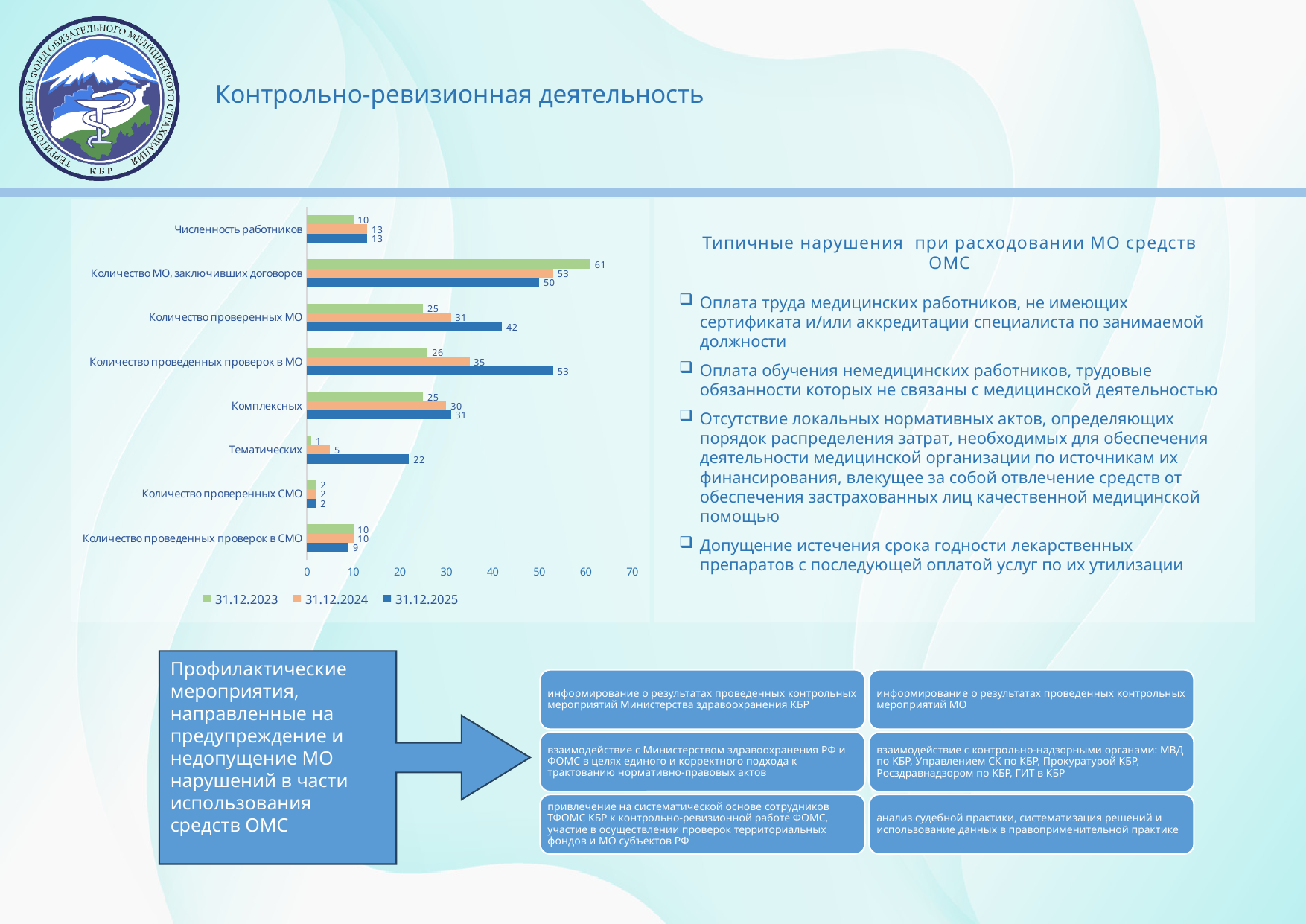
What is the value for "Тематических" in the 31.12.2023 series? 1 How many series does the chart legend list? 3 What is the value for "Количество МО, заключивших договоров" in the 31.12.2024 series? 53 Which category has the highest value in the 31.12.2023 series? Количество МО, заключивших договоров What is the difference between the 31.12.2025 and 31.12.2023 values for "Количество проведенных проверок в МО"? 27 How many categories are shown on the chart? 8 What is the value for "Количество проверенных МО" in the 31.12.2025 series? 42 Is the 31.12.2025 value for "Количество проведенных проверок в МО" greater or less than 50? greater For "Тематических", which series has the larger value: 31.12.2024 or 31.12.2025? 31.12.2025 What are the three series listed in the chart legend? 31.12.2023, 31.12.2024, 31.12.2025 Which category has the lowest value in the 31.12.2025 series? Количество проверенных СМО What kind of chart is shown on the slide? Bar chart